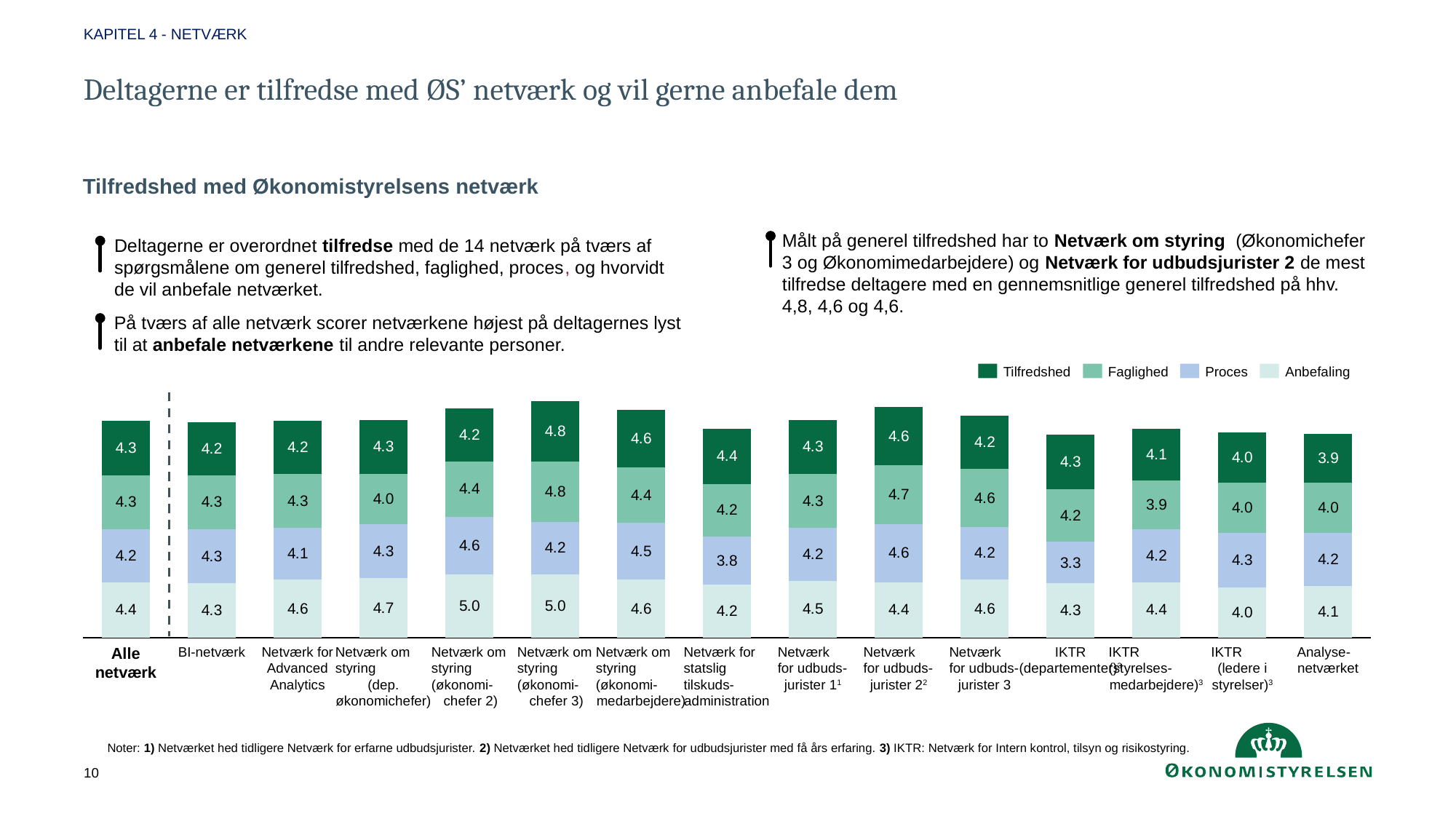
What is the Anbefaling value for Netværk om styring (økonomichefer 2)? 5.0 What is the Proces value for IKTR (departementer)? 3.3 What is the difference between the Anbefaling value for Netværk om styring (dep. økonomichefer) and the Anbefaling value for IKTR (ledere i styrelser)? 0.7 What is the total of the stacked bar for Alle netværk? 17.2 What is the Faglighed value for Analyse-netværket? 4.0 Which network has the lowest Proces value? IKTR (departementer) How many series does the legend list? 4 Which is larger: the Tilfredshed value for Netværk for udbudsjurister 2 or the Tilfredshed value for Netværk for udbudsjurister 3? Netværk for udbudsjurister 2 How many categories (bars) are shown on the chart? 15 Which network has the highest Tilfredshed value? Netværk om styring (økonomichefer 3) What is the Tilfredshed value for Netværk om styring (økonomichefer 3)? 4.8 What kind of chart is shown on the slide? Stacked bar chart